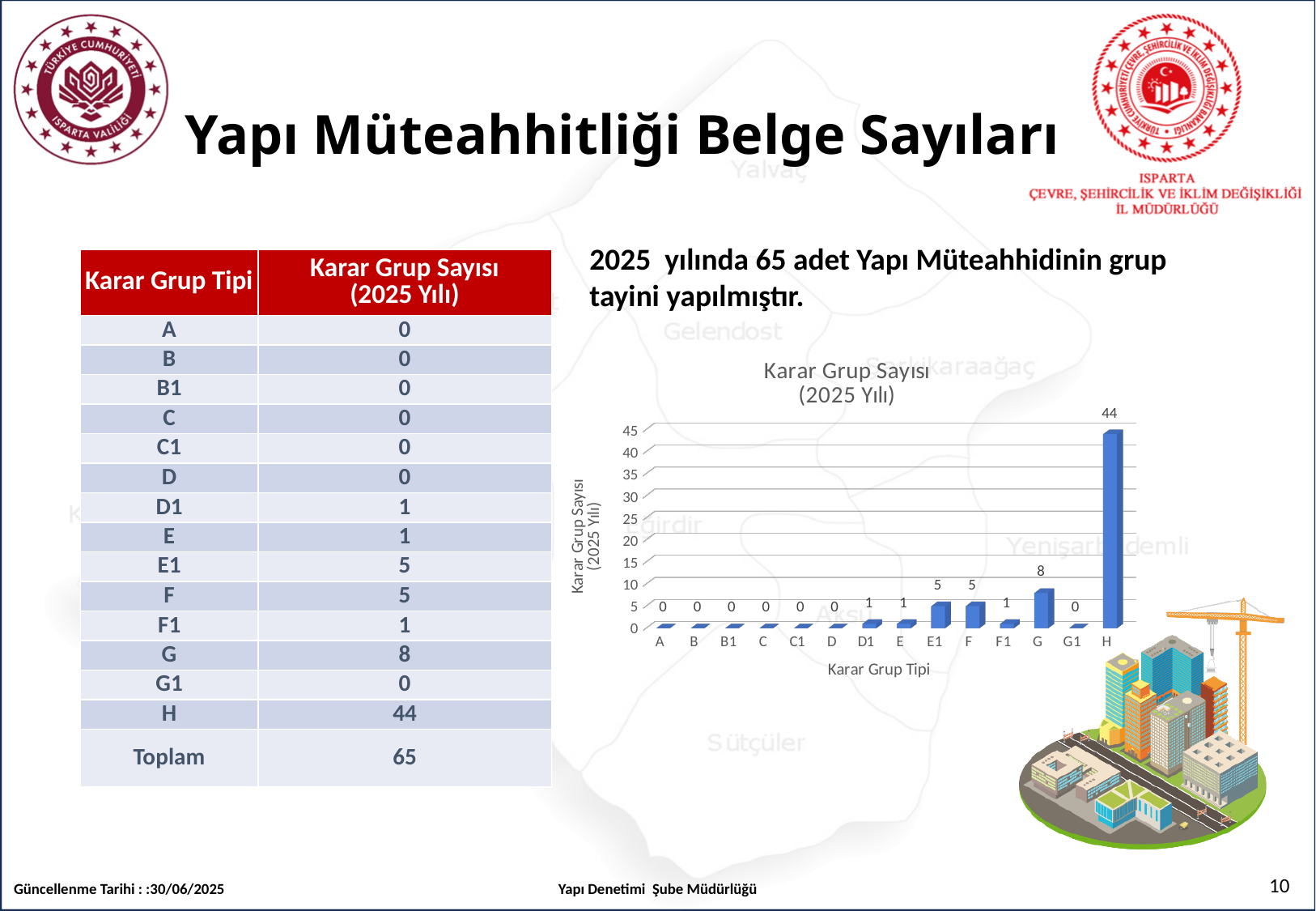
What is the difference between the values for E1 and F1? 4 Which is larger, the value for G or the value for F? G What kind of chart is shown on the slide? bar chart How many categories are shown on the x axis of the chart? 14 What is the difference between the values for H and G? 36 What is the value for G in the chart? 8 What is the value for E1 in the chart? 5 What is the value for H in the chart? 44 Is the value for H greater or less than 40? greater What is the title of the chart? Karar Grup Sayısı (2025 Yılı) Which category has the highest value in the chart? H What is the label of the x axis of the chart? Karar Grup Tipi